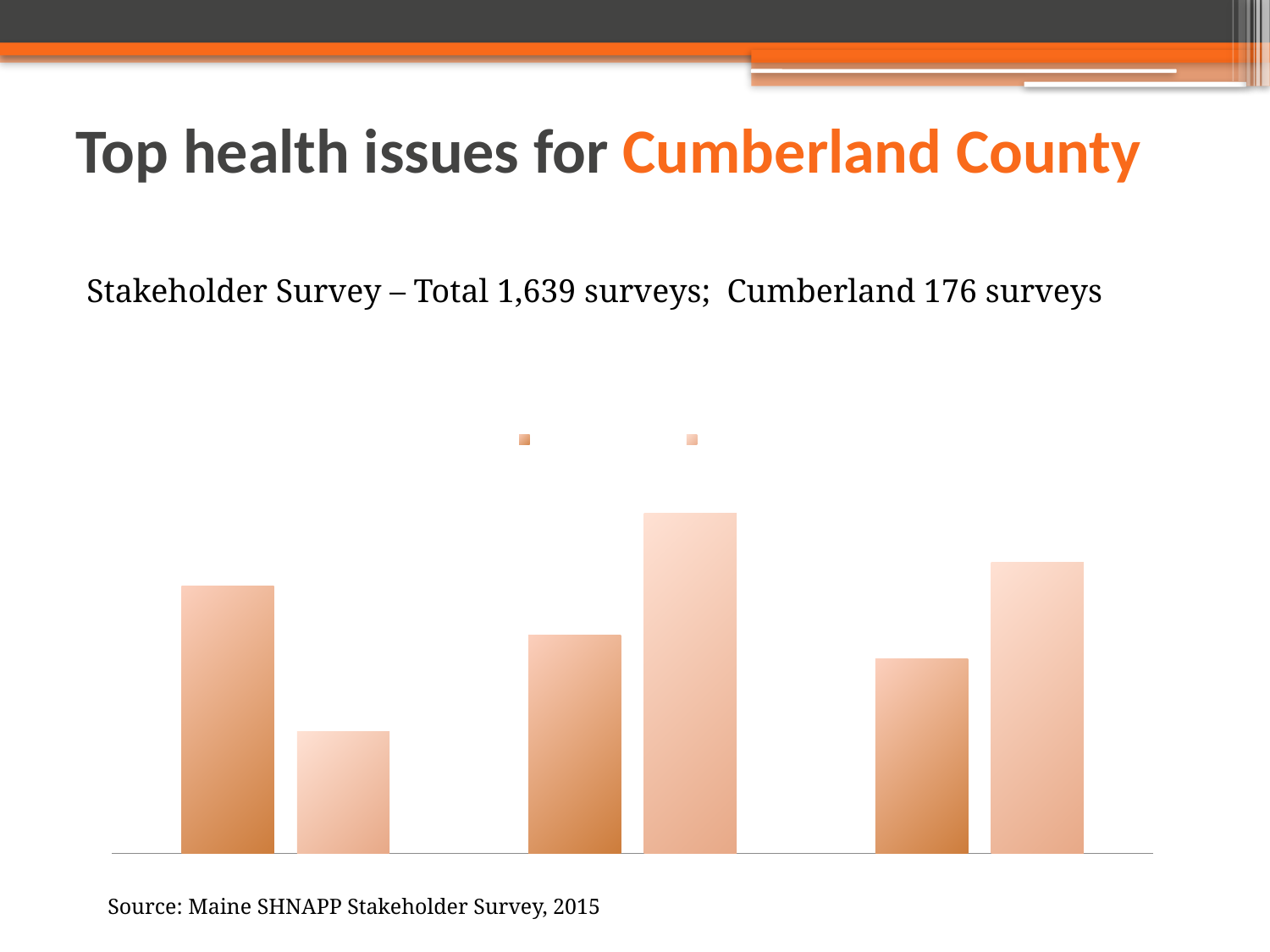
In the rightmost group of bars, is the darker bar or the lighter bar taller? the lighter bar How many bars in total are plotted in the chart? 6 What kind of chart is shown on the slide? bar chart In the middle group of bars, is the darker bar or the lighter bar taller? the lighter bar In the leftmost group of bars, is the darker bar or the lighter bar taller? the darker bar How many series does the legend of the chart list? 2 How many groups of bars are plotted in the chart? 3 Which group of bars contains the shortest bar in the chart: the left, middle, or right group? the left group Which group of bars contains the tallest bar in the chart: the left, middle, or right group? the middle group What colours are used for the two series in the chart? dark orange and light orange